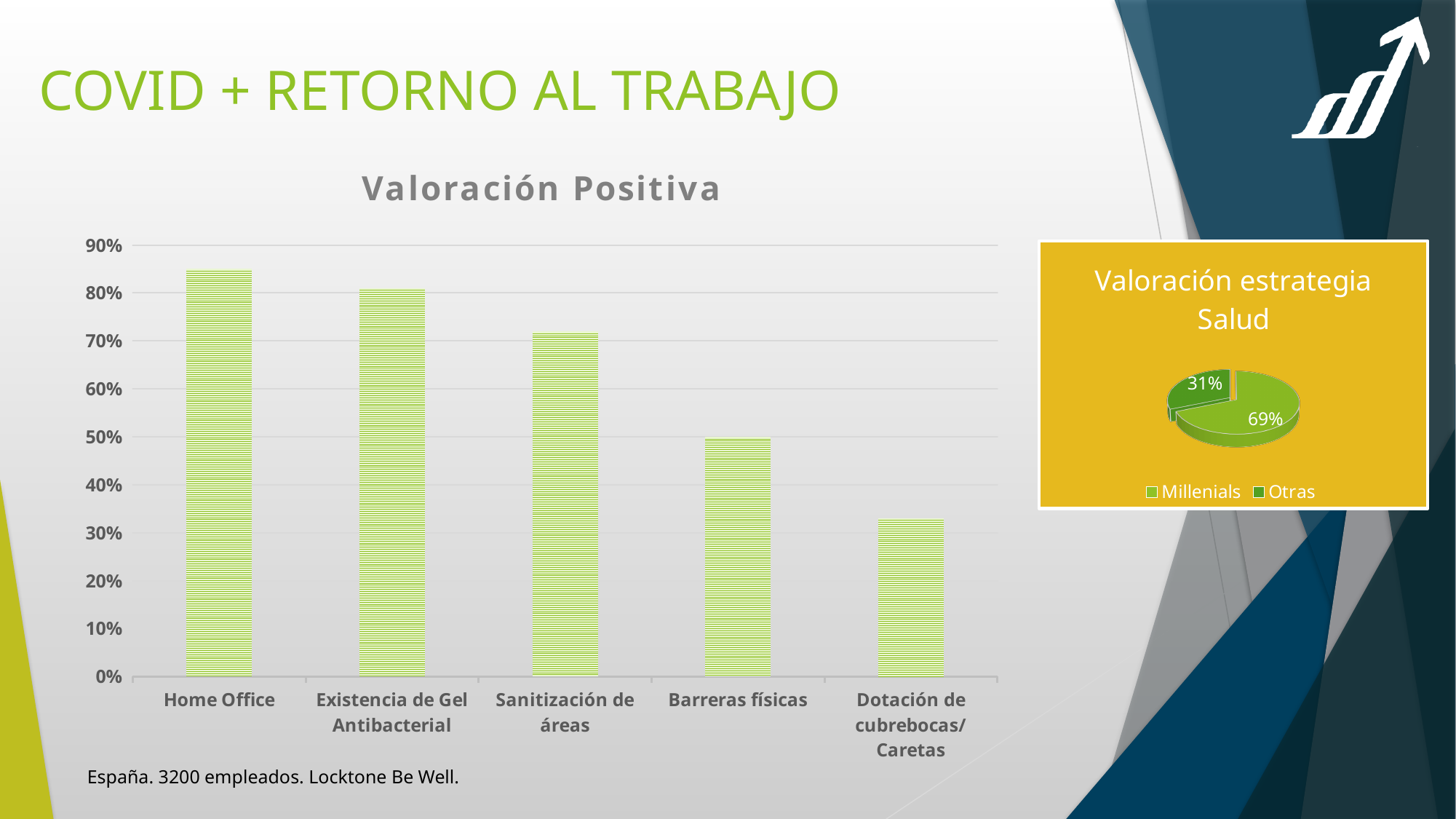
In the 'Valoración Positiva' chart, how many categories are shown? 5 In the 'Valoración estrategia Salud' pie chart, what is the difference between the Millenials and Otras shares? 38% In the 'Valoración Positiva' chart, which is larger: Existencia de Gel Antibacterial or Barreras físicas? Existencia de Gel Antibacterial In the 'Valoración Positiva' chart, is the value for Dotación de cubrebocas/ Caretas greater or less than 40%? less In the 'Valoración Positiva' chart, which category has the highest value? Home Office In the 'Valoración estrategia Salud' pie chart, what share is Otras? 31% In the 'Valoración estrategia Salud' pie chart, what share is Millenials? 69% What kind of chart is 'Valoración Positiva'? bar chart In the 'Valoración Positiva' chart, is the value for Home Office greater or less than 80%? greater In the 'Valoración Positiva' chart, which category has the lowest value? Dotación de cubrebocas/ Caretas In the 'Valoración Positiva' chart, is the value for Sanitización de áreas greater or less than 60%? greater In the 'Valoración Positiva' chart, do the values rise or fall from left to right? fall